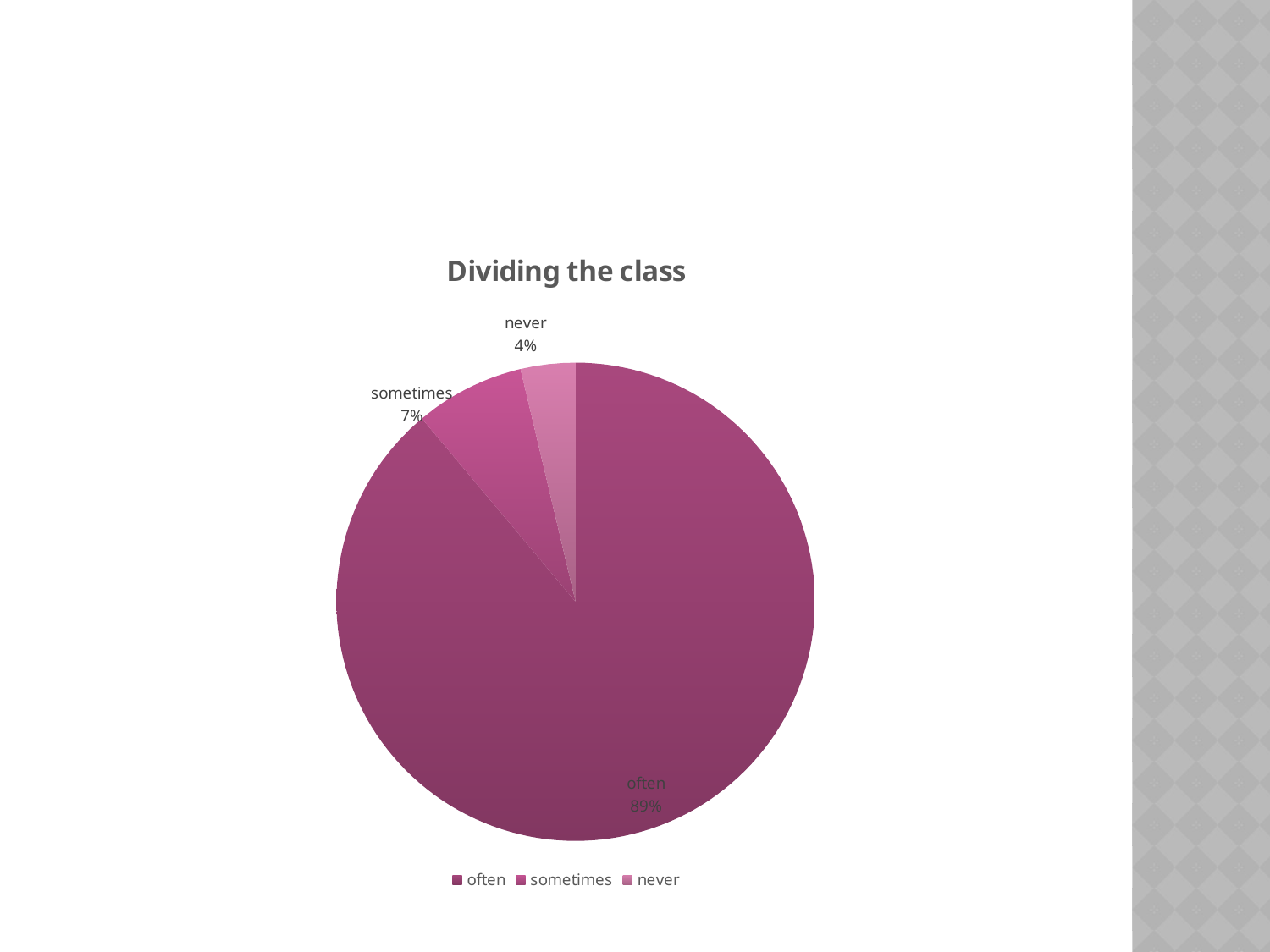
What percentage of the pie is labelled "sometimes"? 7% Which slice is larger, "sometimes" or "never"? sometimes Which category has the largest share of the pie? often What is the difference in percentage points between the "often" and "sometimes" slices? 82 Which category has the smallest share of the pie? never What is the combined share of the "sometimes" and "never" slices? 11% How many slices does the pie chart have? 3 What percentage of the pie is labelled "often"? 89% What is the title of the chart? Dividing the class How many entries does the legend list? 3 What percentage of the pie is labelled "never"? 4% What kind of chart is shown on the slide? pie chart